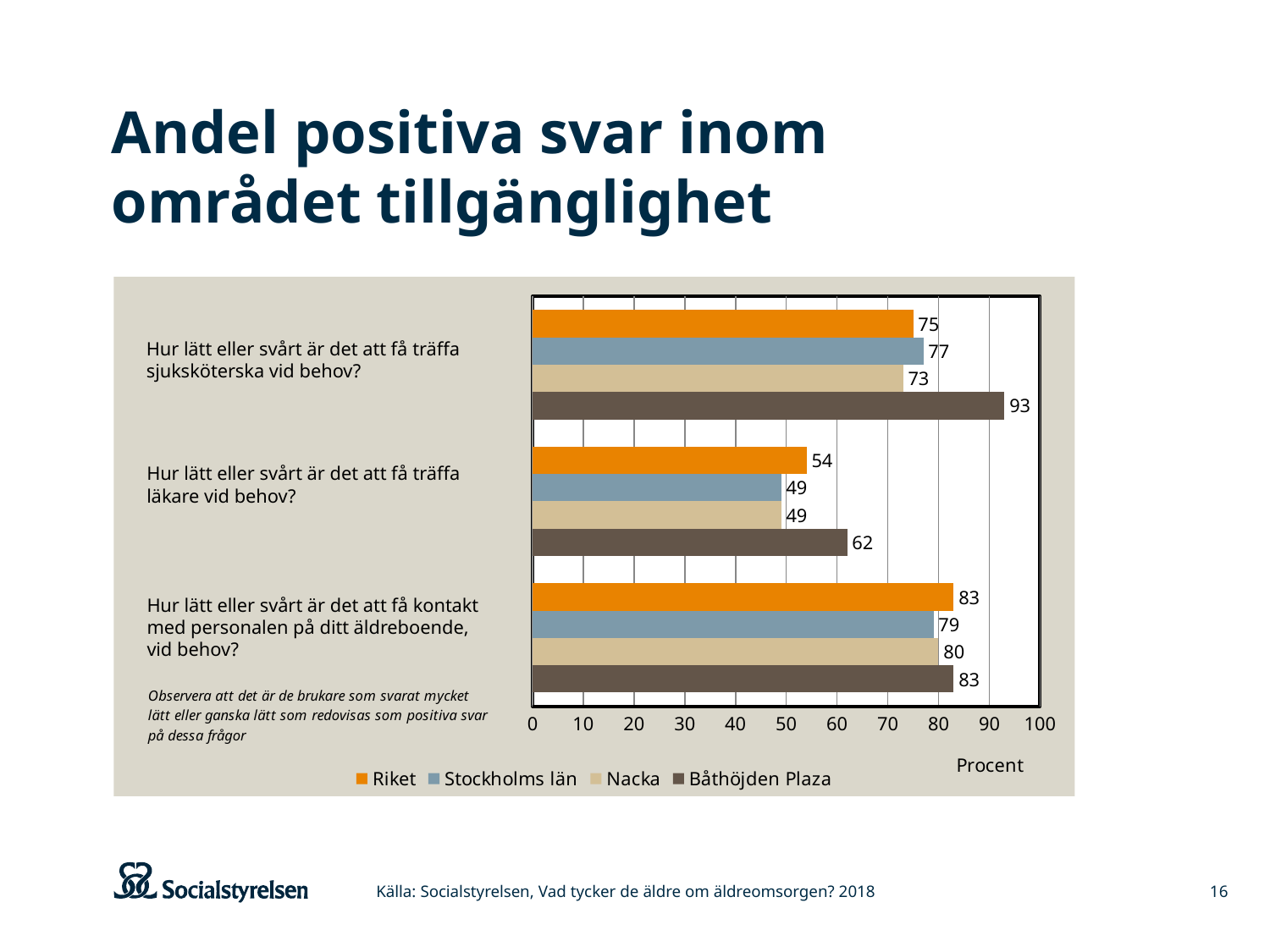
What is the value for Nacka for the question 'Hur lätt eller svårt är det att få kontakt med personalen på ditt äldreboende, vid behov?' 80 What is the label on the x axis of the chart? Procent How many question categories are plotted on the chart? 3 Which series has the highest value for the question 'Hur lätt eller svårt är det att få träffa läkare vid behov?' Båthöjden Plaza How many series does the legend list? 4 Which series has the lowest value for the question 'Hur lätt eller svårt är det att få träffa sjuksköterska vid behov?' Nacka Is the value for Båthöjden Plaza for the question 'Hur lätt eller svårt är det att få träffa läkare vid behov?' greater or less than 70? less What is the difference between Båthöjden Plaza and Riket for the question 'Hur lätt eller svårt är det att få träffa sjuksköterska vid behov?' 18 What kind of chart is shown on the slide? Bar chart For the question 'Hur lätt eller svårt är det att få träffa läkare vid behov?', which is larger: the value for Riket or the value for Stockholms län? Riket What is the value for Riket for the question 'Hur lätt eller svårt är det att få träffa läkare vid behov?' 54 What is the value for Båthöjden Plaza for the question 'Hur lätt eller svårt är det att få träffa sjuksköterska vid behov?' 93